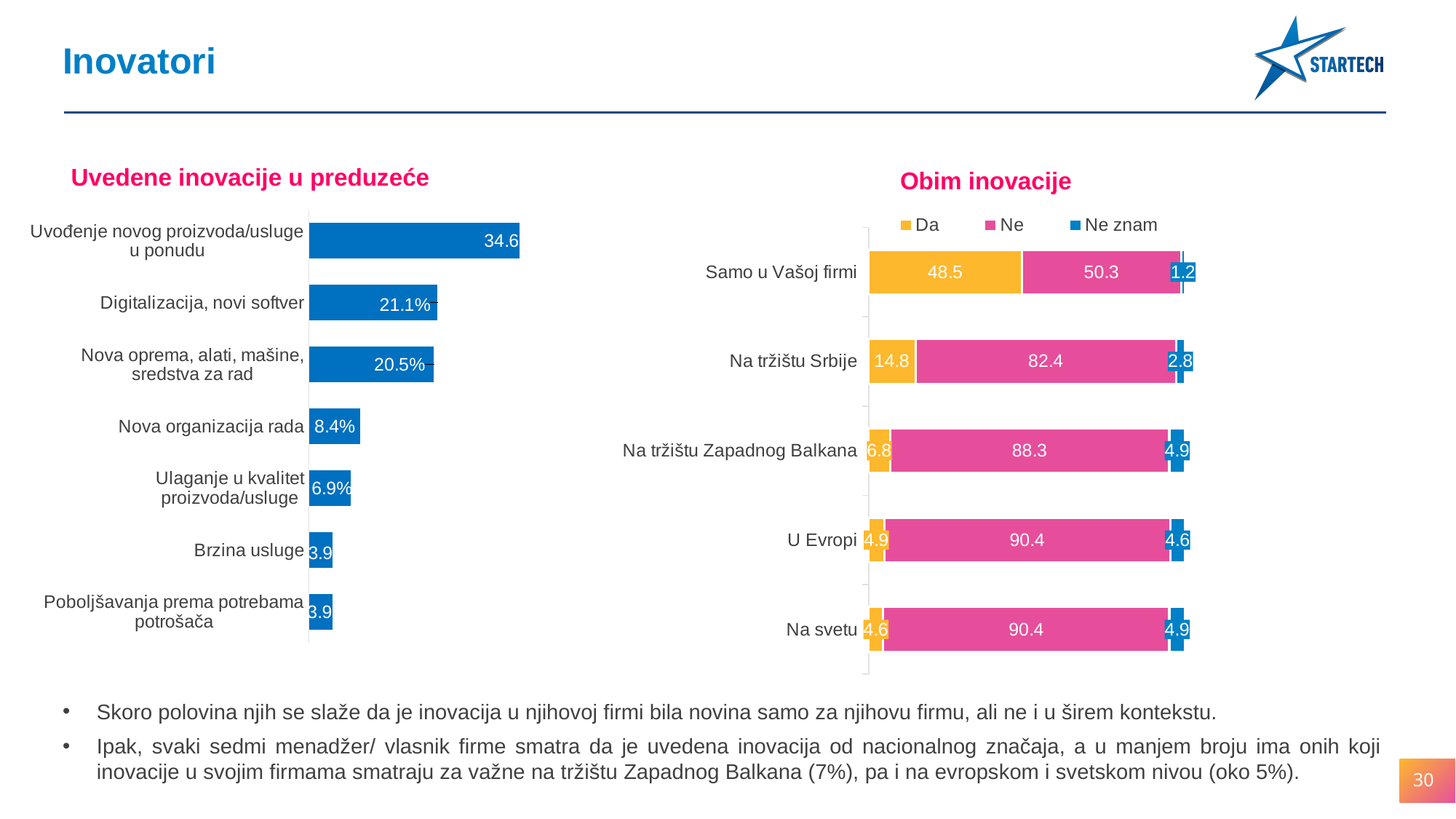
In the 'Uvedene inovacije u preduzeće' chart, what is the difference between 'Digitalizacija, novi softver' and 'Nova oprema, alati, mašine, sredstva za rad'? 0.6% In the 'Uvedene inovacije u preduzeće' chart, what is the value for 'Uvođenje novog proizvoda/usluge u ponudu'? 34.6 In the 'Uvedene inovacije u preduzeće' chart, which is larger: 'Nova organizacija rada' or 'Ulaganje u kvalitet proizvoda/usluge'? Nova organizacija rada In the 'Uvedene inovacije u preduzeće' chart, which category has the highest value? Uvođenje novog proizvoda/usluge u ponudu In the 'Obim inovacije' chart, what is the 'Da' value for 'Samo u Vašoj firmi'? 48.5 In the 'Obim inovacije' chart, which category has the lowest 'Ne znam' value? Samo u Vašoj firmi In the 'Uvedene inovacije u preduzeće' chart, how many categories are shown? 7 In the 'Obim inovacije' chart, what is the total of the stacked bar for 'Na tržištu Zapadnog Balkana'? 100.0 In the 'Obim inovacije' chart, how many series does the legend list? 3 In the 'Uvedene inovacije u preduzeće' chart, what is the value for 'Nova organizacija rada'? 8.4% What kind of chart is 'Obim inovacije'? Stacked bar chart In the 'Obim inovacije' chart, what is the 'Ne' value for 'Na tržištu Srbije'? 82.4